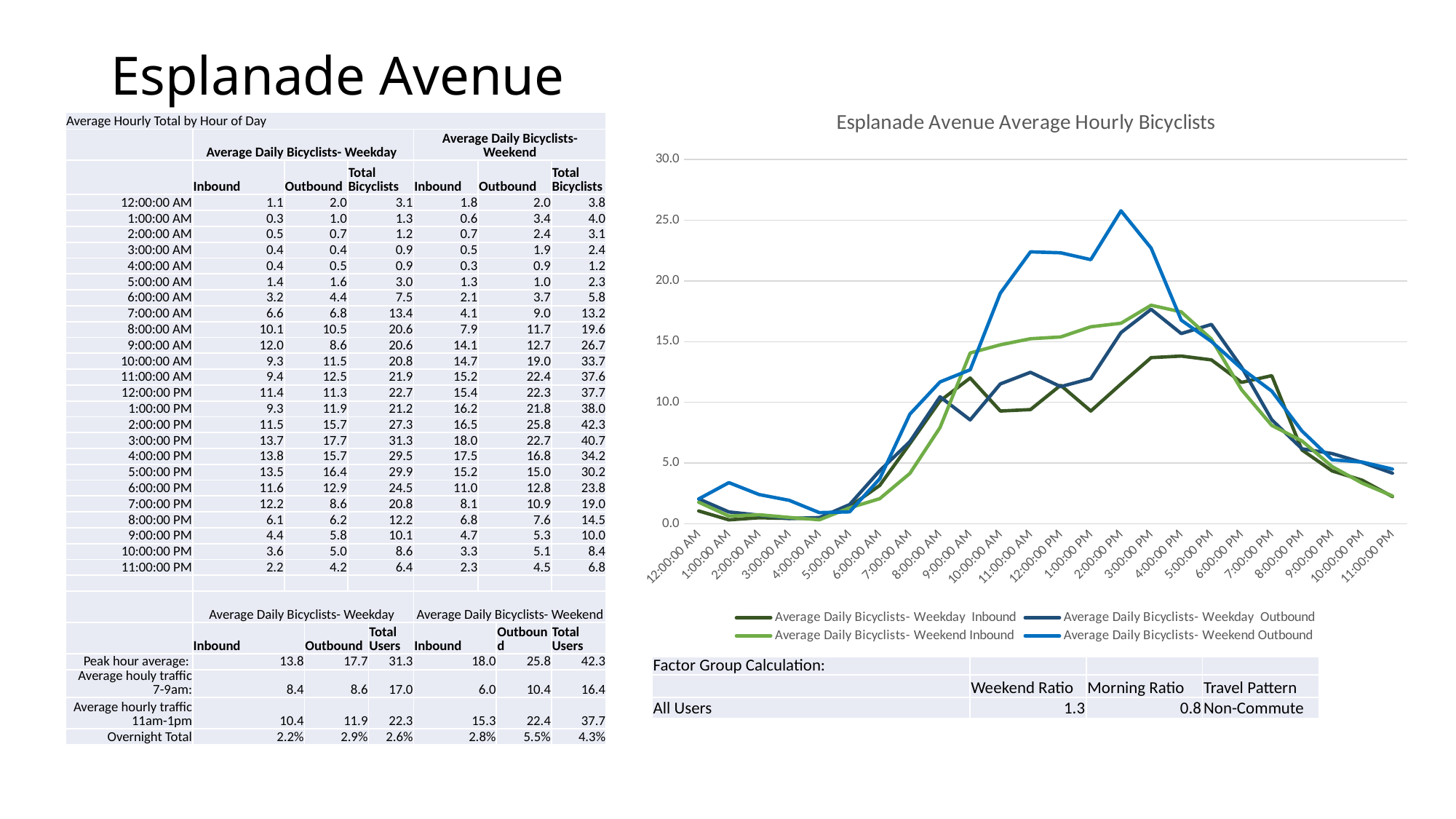
How many hourly points are plotted along the x axis of the 'Esplanade Avenue Average Hourly Bicyclists' chart? 24 How many series does the legend of the 'Esplanade Avenue Average Hourly Bicyclists' chart list? 4 According to the slide, what is the Weekday Inbound value at 4:00:00 PM? 13.8 In the 'Esplanade Avenue Average Hourly Bicyclists' chart, does the Weekend Outbound line rise or fall from 5:00:00 AM to 11:00:00 AM? rise In the 'Esplanade Avenue Average Hourly Bicyclists' chart, is the Weekend Outbound value at 2:00:00 PM greater or less than 25.0? greater In the 'Esplanade Avenue Average Hourly Bicyclists' chart, which series reaches the highest peak? Average Daily Bicyclists- Weekend Outbound In the 'Esplanade Avenue Average Hourly Bicyclists' chart, is the Weekend Inbound value at 10:00:00 AM greater or less than 10.0? greater In the 'Esplanade Avenue Average Hourly Bicyclists' chart, is the Weekday Inbound value at 3:00:00 AM greater or less than 5.0? less What is the title of the chart on the slide? Esplanade Avenue Average Hourly Bicyclists According to the slide, what is the difference between the Weekend Outbound and Weekday Inbound values at 2:00:00 PM? 14.3 What kind of chart is 'Esplanade Avenue Average Hourly Bicyclists'? line chart In the 'Esplanade Avenue Average Hourly Bicyclists' chart, which is larger at 11:00:00 AM: Weekend Outbound or Weekday Inbound? Weekend Outbound